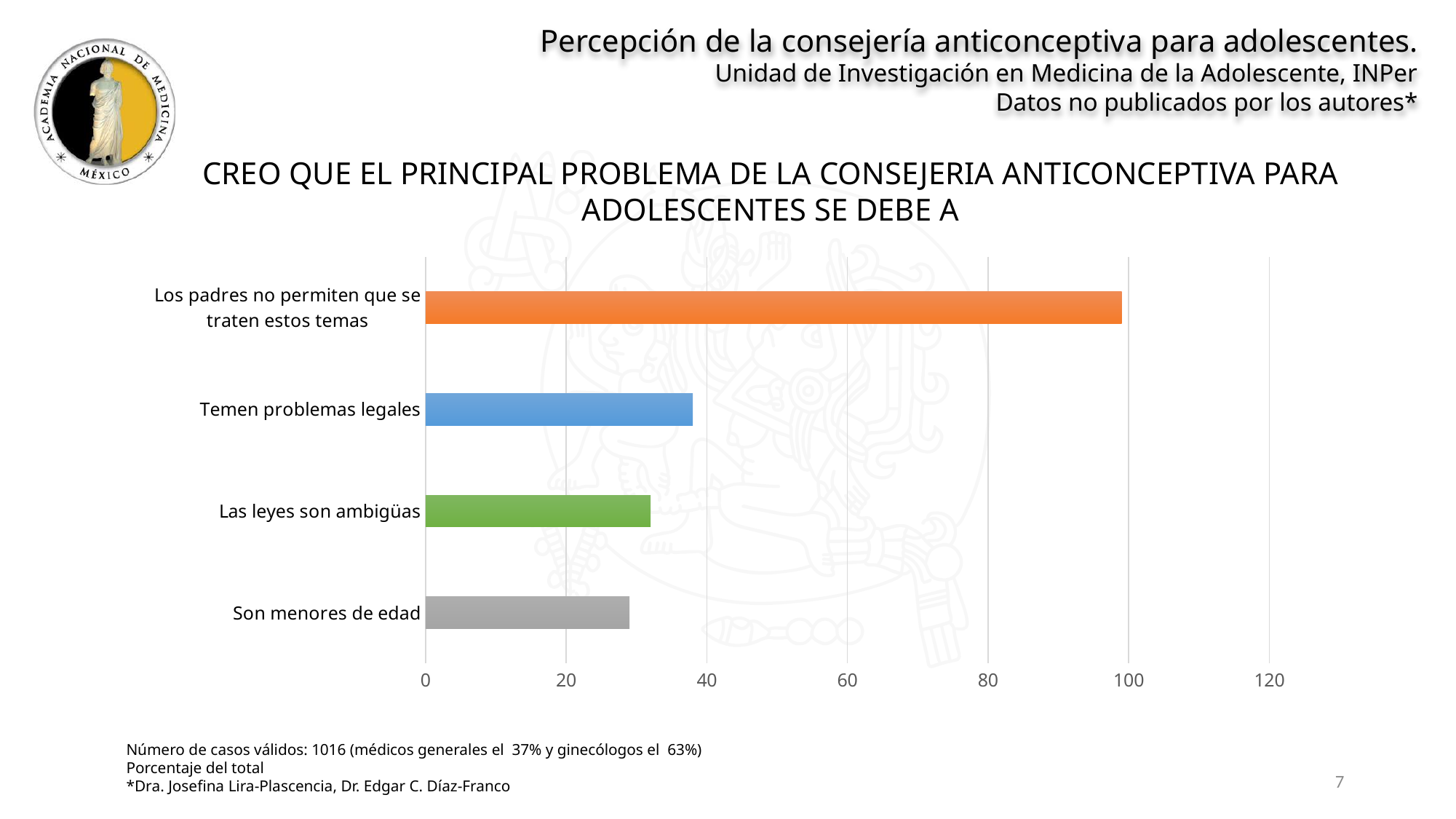
Which is larger, the value for 'Los padres no permiten que se traten estos temas' or the value for 'Son menores de edad'? Los padres no permiten que se traten estos temas Is the value for 'Temen problemas legales' greater or less than 60? less What colour is the bar for 'Las leyes son ambigüas'? green Is the value for 'Las leyes son ambigüas' greater or less than 40? less Is the value for 'Son menores de edad' greater or less than 20? greater How many categories are plotted in the chart? 4 Which category has the highest value in the chart? Los padres no permiten que se traten estos temas What kind of chart is shown on the slide? bar chart Which is larger, the value for 'Temen problemas legales' or the value for 'Las leyes son ambigüas'? Temen problemas legales What is the highest tick value shown on the horizontal axis of the chart? 120 Which category has the lowest value in the chart? Son menores de edad